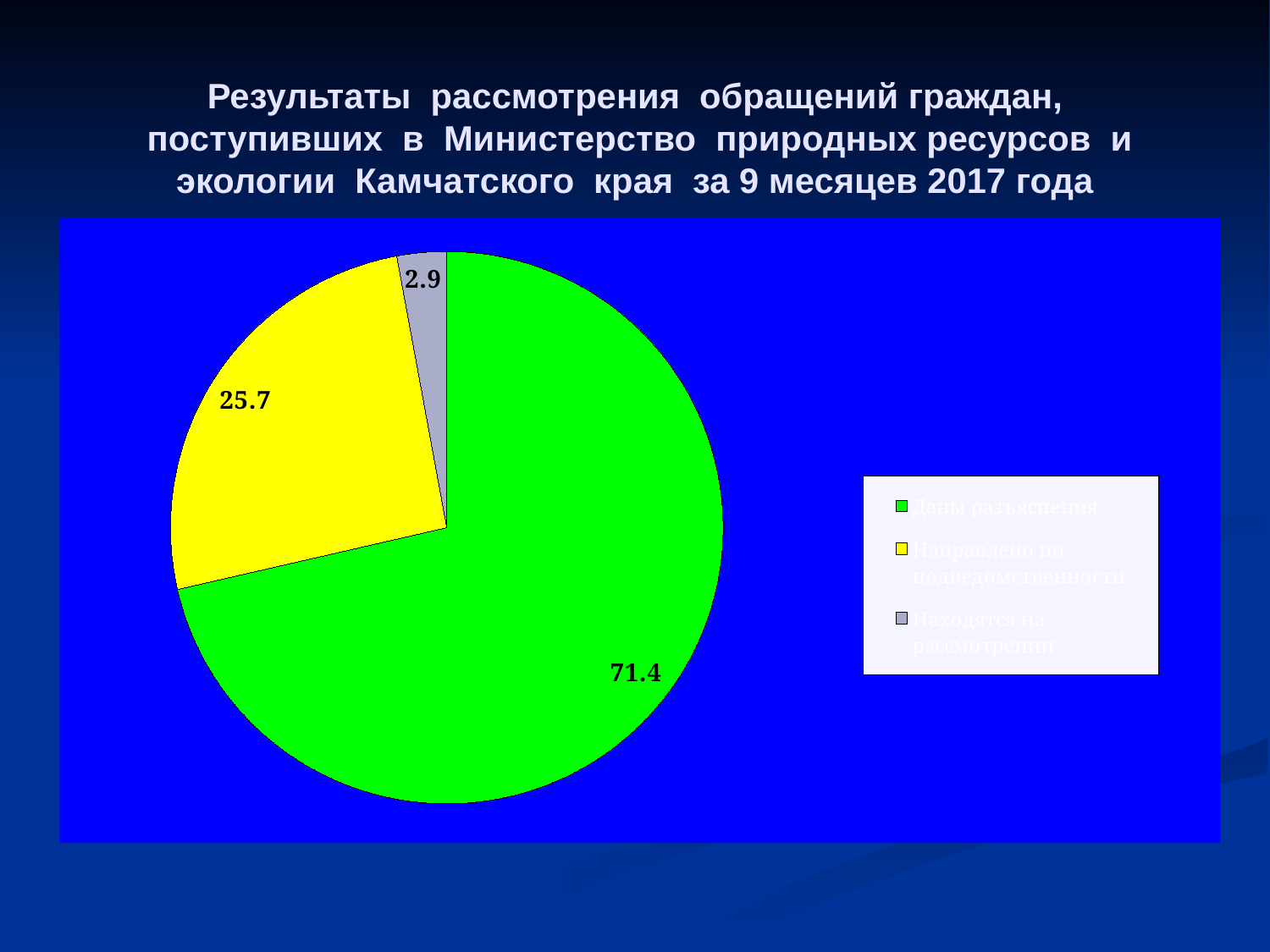
How many entries does the legend list? 3 What value is shown for the yellow slice (Направлено по подведомственности)? 25.7 Which slice of the pie chart is the largest? Даны разъяснения (71.4) What value is shown for the green slice (Даны разъяснения)? 71.4 What kind of chart is shown on the slide? pie chart Which legend entry is shown in green? Даны разъяснения What is the difference between the green slice (71.4) and the yellow slice (25.7)? 45.7 Which slice of the pie chart is the smallest? Находятся на рассмотрении (2.9) What colour is the slice labelled 2.9? grey Which is larger, the yellow slice or the grey slice? the yellow slice (25.7) What value is shown for the grey slice (Находятся на рассмотрении)? 2.9 How many slices does the pie chart have? 3